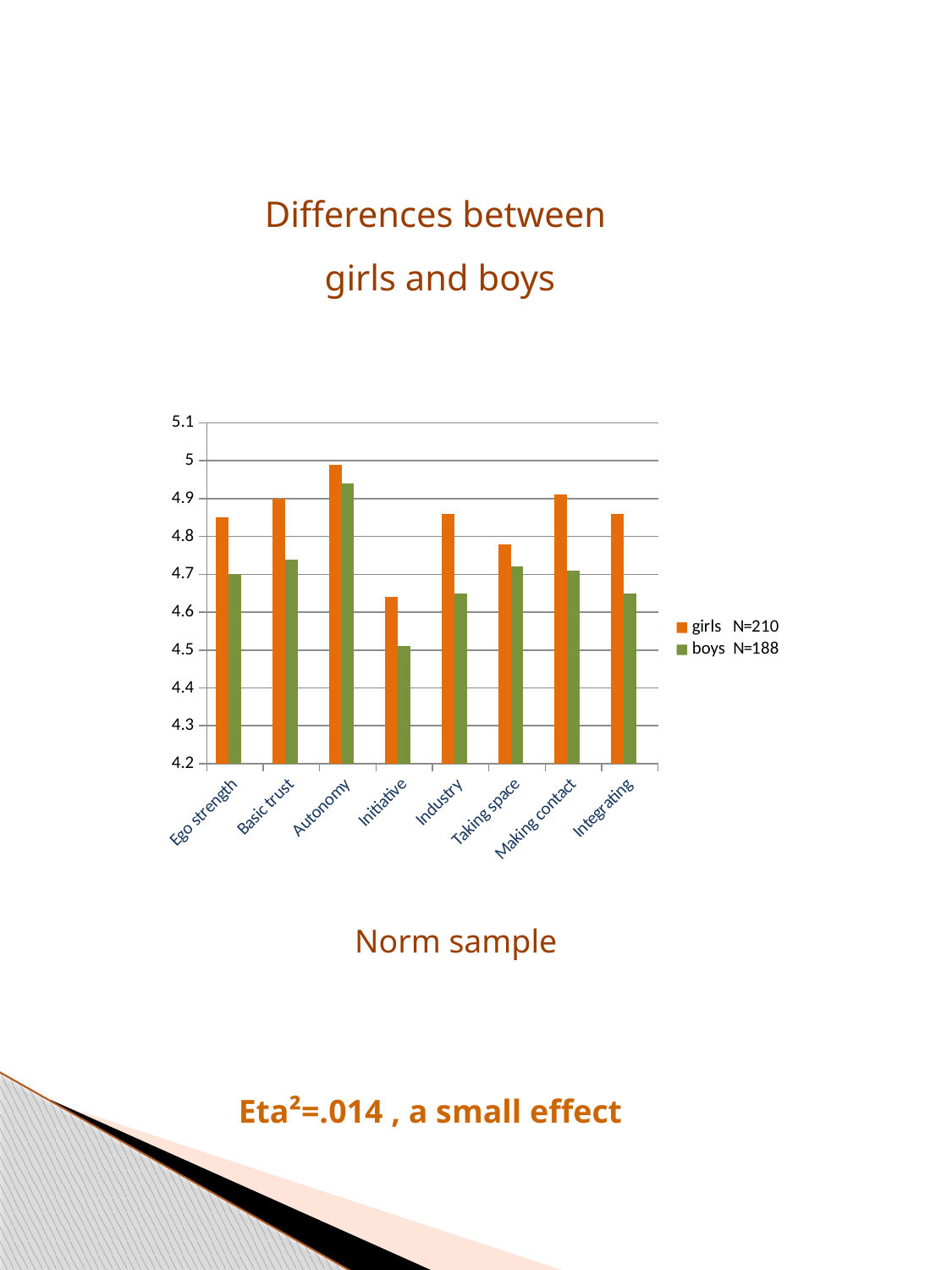
For Industry, which is larger: the value for girls or the value for boys? girls What kind of chart is shown on the slide? bar chart Which colour represents girls in the chart? orange Is the value for boys on Industry greater or less than 4.7? less What is the sample size for boys given in the legend? N=188 Is the value for boys on Initiative greater or less than 4.6? less How many series does the chart's legend list? 2 Which category has the lowest value for girls? Initiative Which category has the highest value for girls? Autonomy Which category has the lowest value for boys? Initiative Is the value for girls on Autonomy greater or less than 4.9? greater How many categories are shown on the x axis of the chart? 8